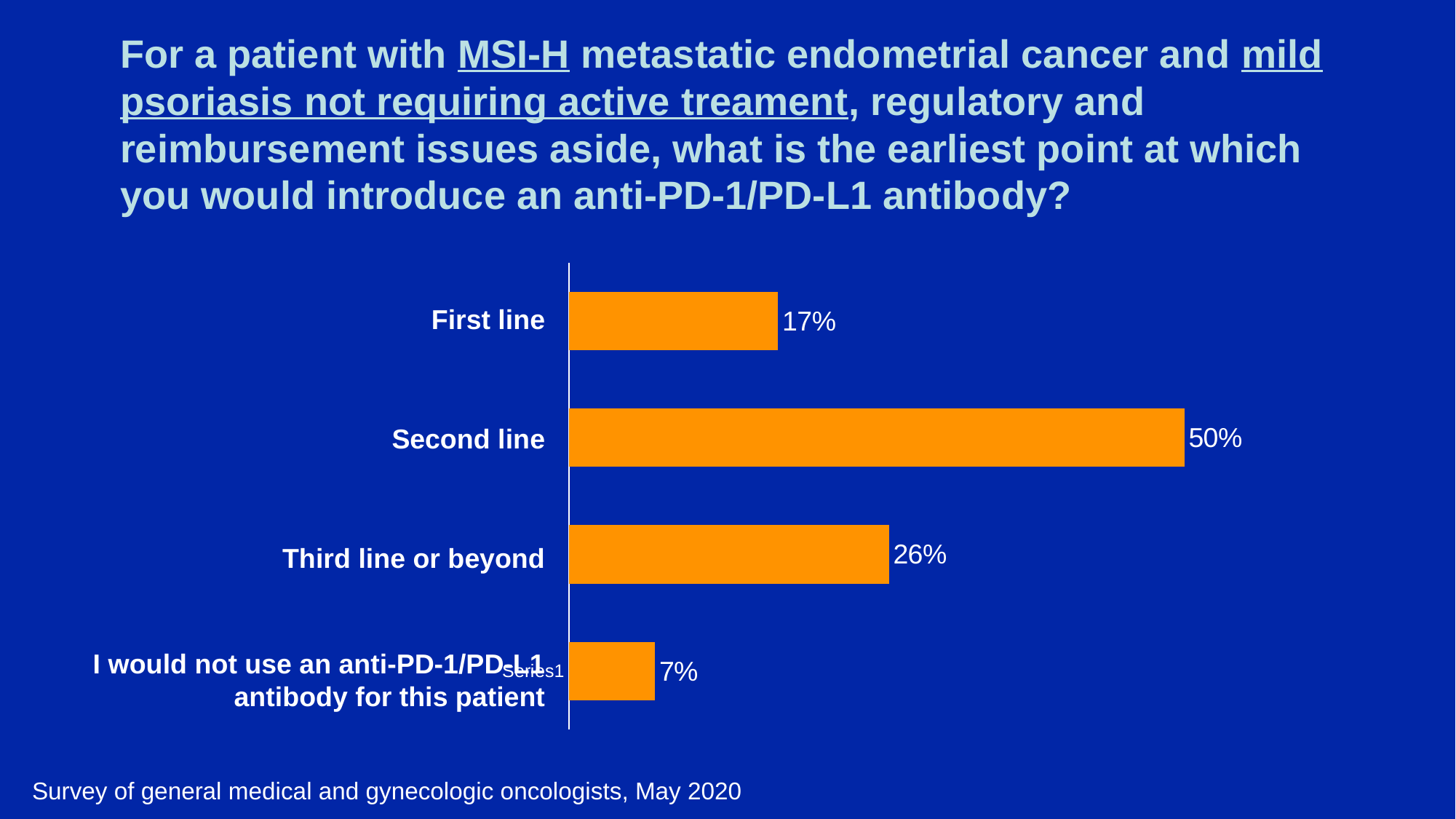
What percentage of respondents said they would not use an anti-PD-1/PD-L1 antibody for this patient? 7% What percentage of respondents chose 'Second line'? 50% What type of chart is shown on the slide? Bar chart What colour are the bars in the chart? Orange Which response option has the lowest percentage? I would not use an anti-PD-1/PD-L1 antibody for this patient Which has a larger percentage, 'First line' or 'Third line or beyond'? Third line or beyond What percentage of respondents chose 'First line'? 17% What is the difference in percentage points between 'Second line' and 'Third line or beyond'? 24 What is the difference in percentage points between 'First line' and 'I would not use an anti-PD-1/PD-L1 antibody for this patient'? 10 What percentage of respondents chose 'Third line or beyond'? 26% How many response categories are shown in the chart? 4 Which response option has the highest percentage? Second line